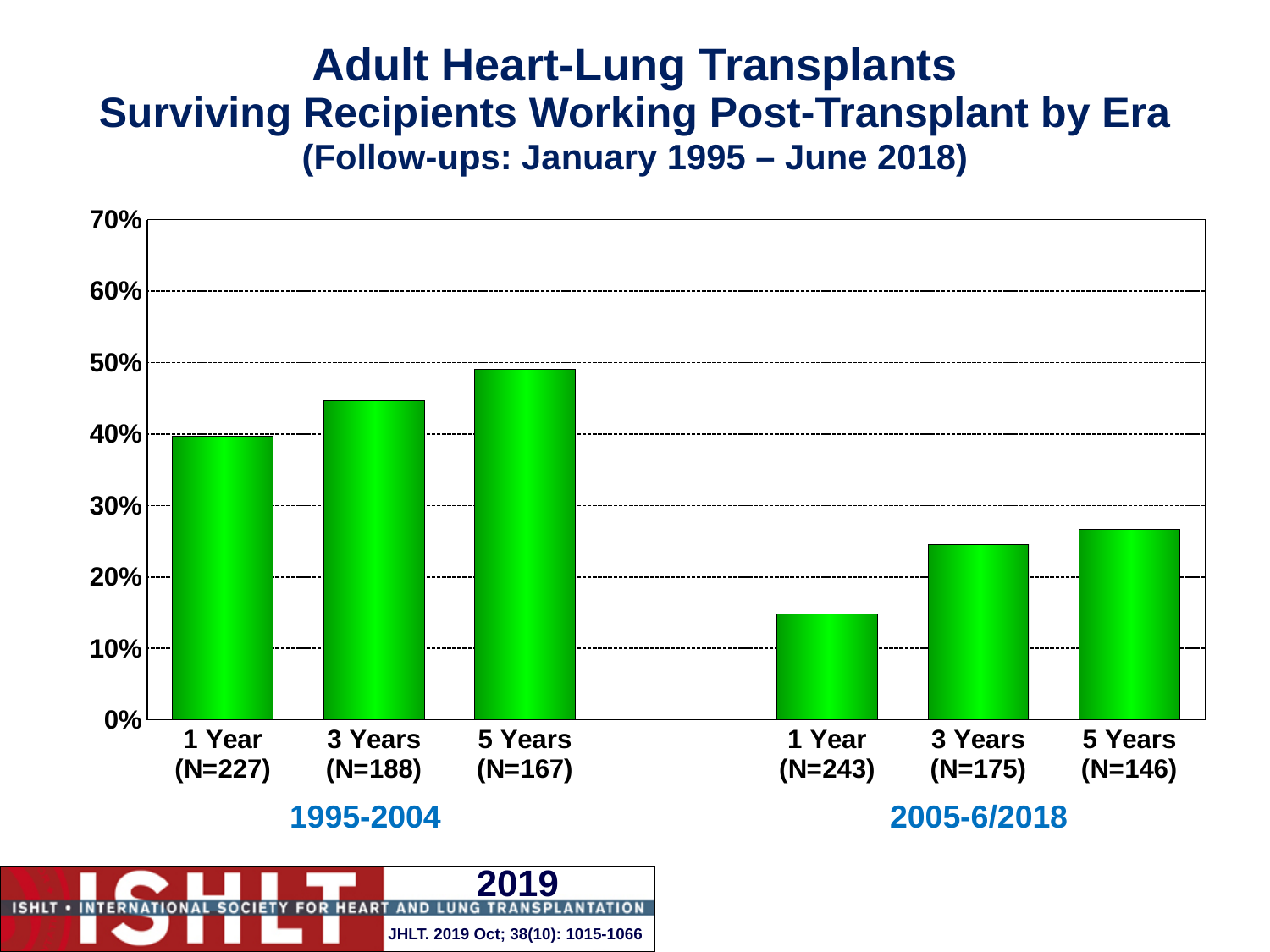
What is the N for the 1 Year bar in the 1995-2004 era? N=227 What kind of chart is shown on the slide? bar chart Is the value for 5 Years in the 1995-2004 era greater or less than 40%? greater Is the value for 3 Years in the 2005-6/2018 era greater or less than 20%? greater Which is larger: the 1 Year value for 1995-2004 or the 1 Year value for 2005-6/2018? 1 Year value for 1995-2004 Which bar has the lowest value in the chart? 1 Year (N=243), 2005-6/2018 Is the value for 1 Year in the 2005-6/2018 era greater or less than 20%? less How many bars are plotted in the chart? 6 Within the 2005-6/2018 era, do the values rise or fall from 1 Year to 5 Years? rise Which bar has the highest value in the chart? 5 Years (N=167), 1995-2004